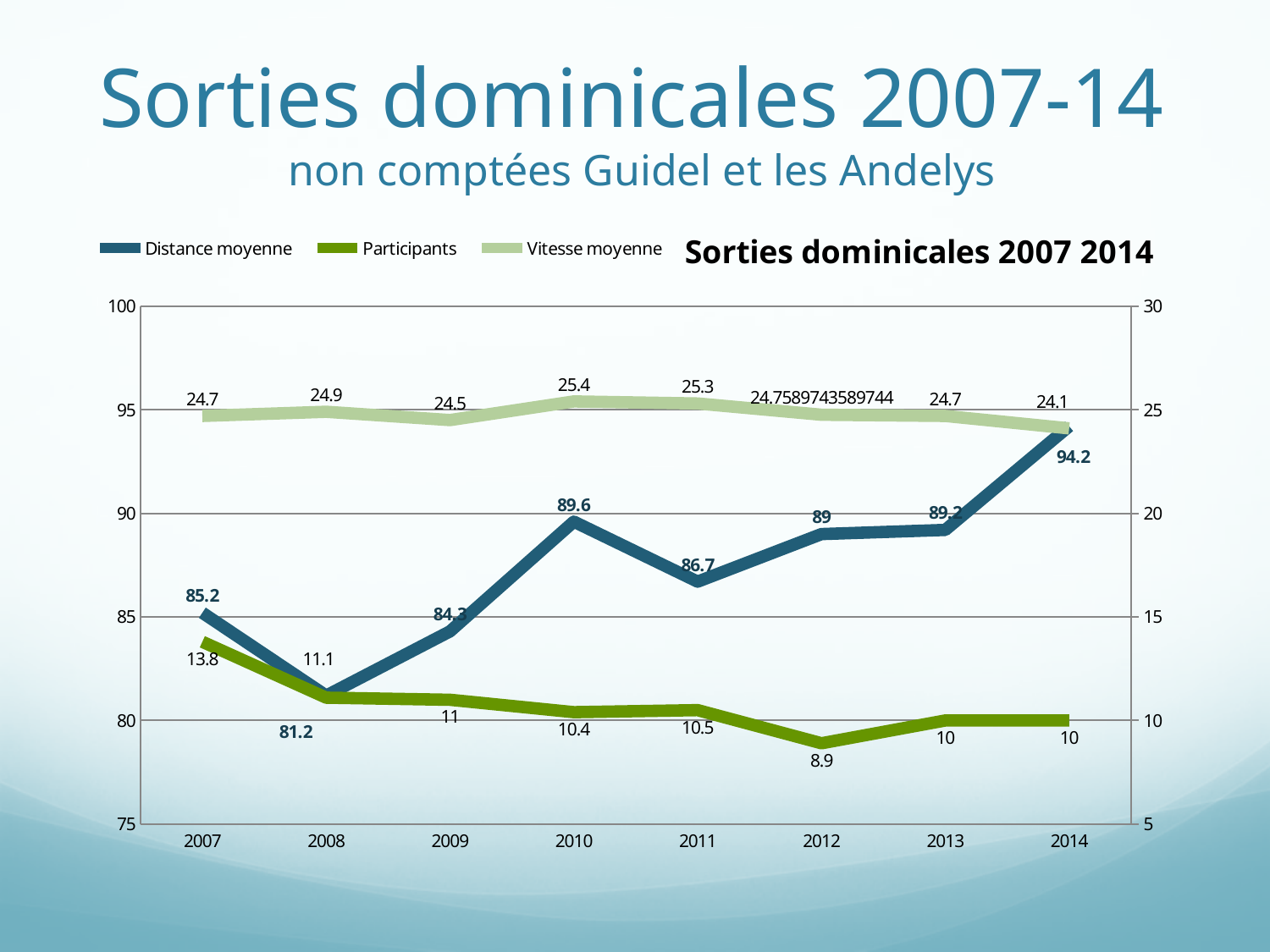
Which is larger, the Participants value for 2007 or for 2008? 2007 In which year is Participants highest? 2007 What is the title of the chart? Sorties dominicales 2007 2014 How many series does the legend list? 3 What is the Participants value for 2012? 8.9 How many years are plotted on the x axis? 8 What kind of chart is shown? line chart Does Distance moyenne rise or fall from 2011 to 2014? rise What is the Vitesse moyenne value for 2010? 25.4 In which year is Distance moyenne lowest? 2008 What is the Distance moyenne value for 2014? 94.2 What is the difference between the Distance moyenne values for 2014 and 2007? 9